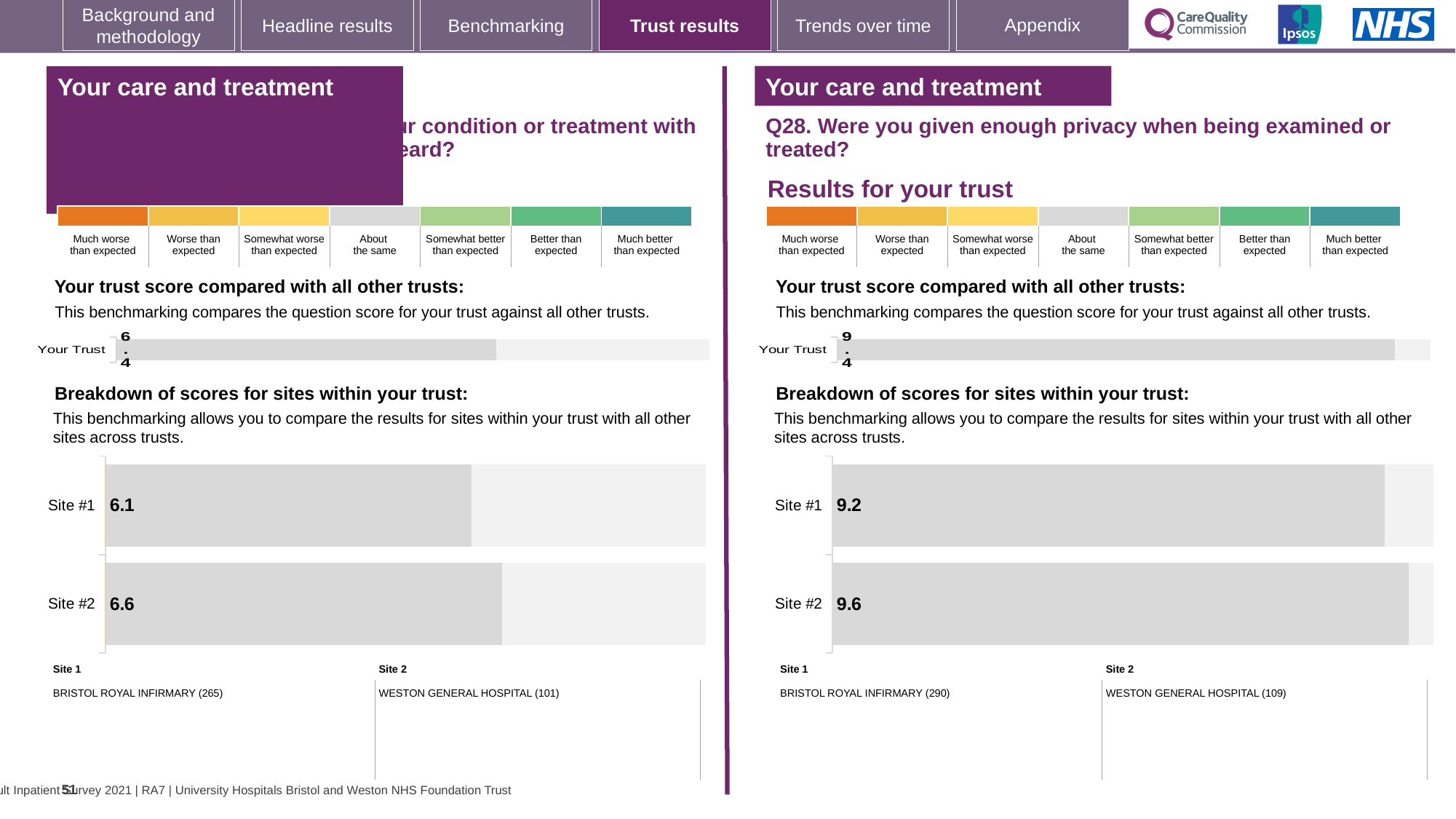
On the left-hand chart, what is the difference between the Site #2 and Site #1 scores? 0.5 On the right-hand chart (Q28, privacy when being examined or treated), what is the score for Site #1? 9.2 On the left-hand chart, what is the score shown for Your Trust? 6.4 On the right-hand chart (Q28), which site has the lower score? Site #1 On the left-hand chart, which site has the higher score? Site #2 On the right-hand chart (Q28), what is the score for Site #2? 9.6 On the left-hand chart, what is the score for Site #1? 6.1 On the left-hand chart, what is the score for Site #2? 6.6 On the right-hand chart (Q28), what is the score shown for Your Trust? 9.4 What type of chart is used for the breakdown of scores for sites on the left-hand side? Bar chart How many sites are shown in the site breakdown chart on the right-hand side (Q28)? 2 On the right-hand chart (Q28), what is the difference between the Site #2 and Site #1 scores? 0.4